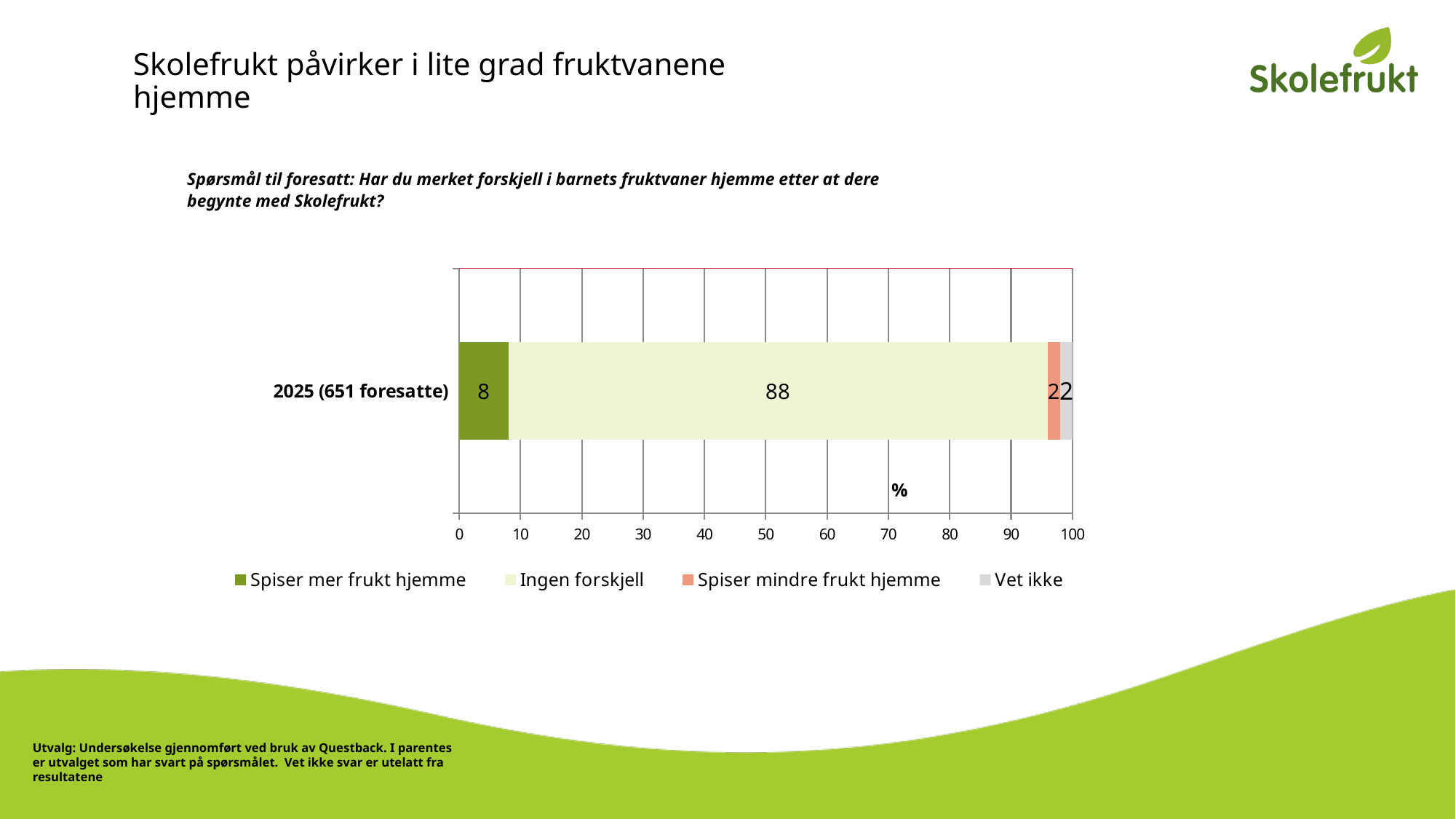
How many categories are plotted on the y axis? 1 Which series has the highest value for 2025 (651 foresatte)? Ingen forskjell What kind of chart is shown on the slide? bar chart What is the value for "Vet ikke" for 2025 (651 foresatte)? 2 What is the difference between "Ingen forskjell" and "Spiser mer frukt hjemme" for 2025 (651 foresatte)? 80 What is the value for "Spiser mer frukt hjemme" for 2025 (651 foresatte)? 8 What is the value for "Spiser mindre frukt hjemme" for 2025 (651 foresatte)? 2 What is the value for "Ingen forskjell" for 2025 (651 foresatte)? 88 Which is larger for 2025 (651 foresatte): "Spiser mer frukt hjemme" or "Spiser mindre frukt hjemme"? Spiser mer frukt hjemme What is the total of the stacked bar for 2025 (651 foresatte)? 100 How many series does the legend list? 4 What label is shown on the category axis of the chart? 2025 (651 foresatte)